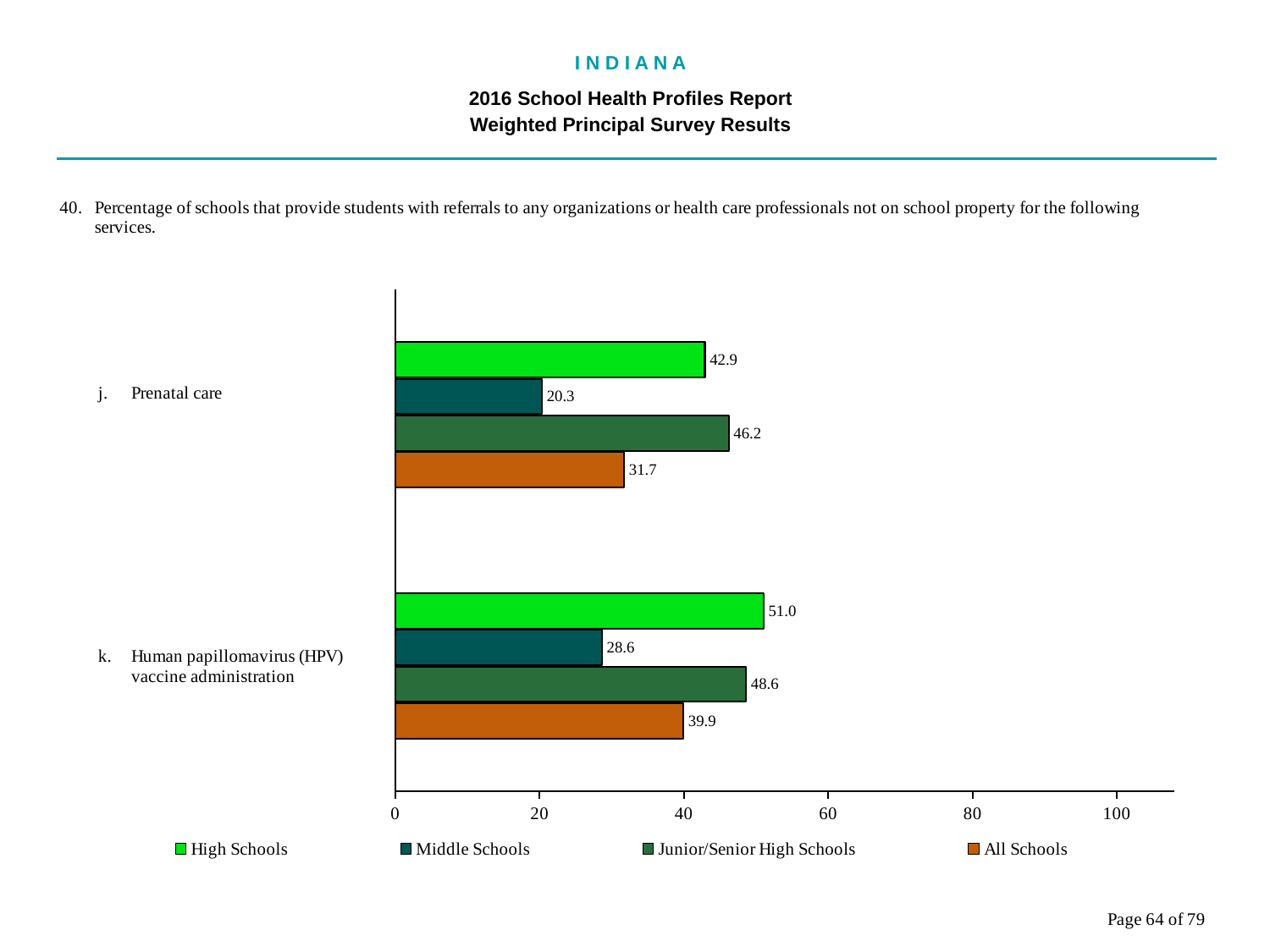
Which is larger for Human papillomavirus (HPV) vaccine administration: the High Schools value or the All Schools value? High Schools What colour are the All Schools bars? Orange Is the value for Junior/Senior High Schools for Human papillomavirus (HPV) vaccine administration greater or less than 40? greater What is the value for All Schools for Prenatal care? 31.7 What is the difference between the High Schools and Middle Schools values for Prenatal care? 22.6 How many service categories are shown in the chart? 2 How many series does the legend list? 4 Which school type has the highest value for Prenatal care? Junior/Senior High Schools Which school type has the lowest value for Human papillomavirus (HPV) vaccine administration? Middle Schools What is the value for High Schools for Prenatal care? 42.9 What is the value for Middle Schools for Human papillomavirus (HPV) vaccine administration? 28.6 What kind of chart is shown on the slide? Bar chart